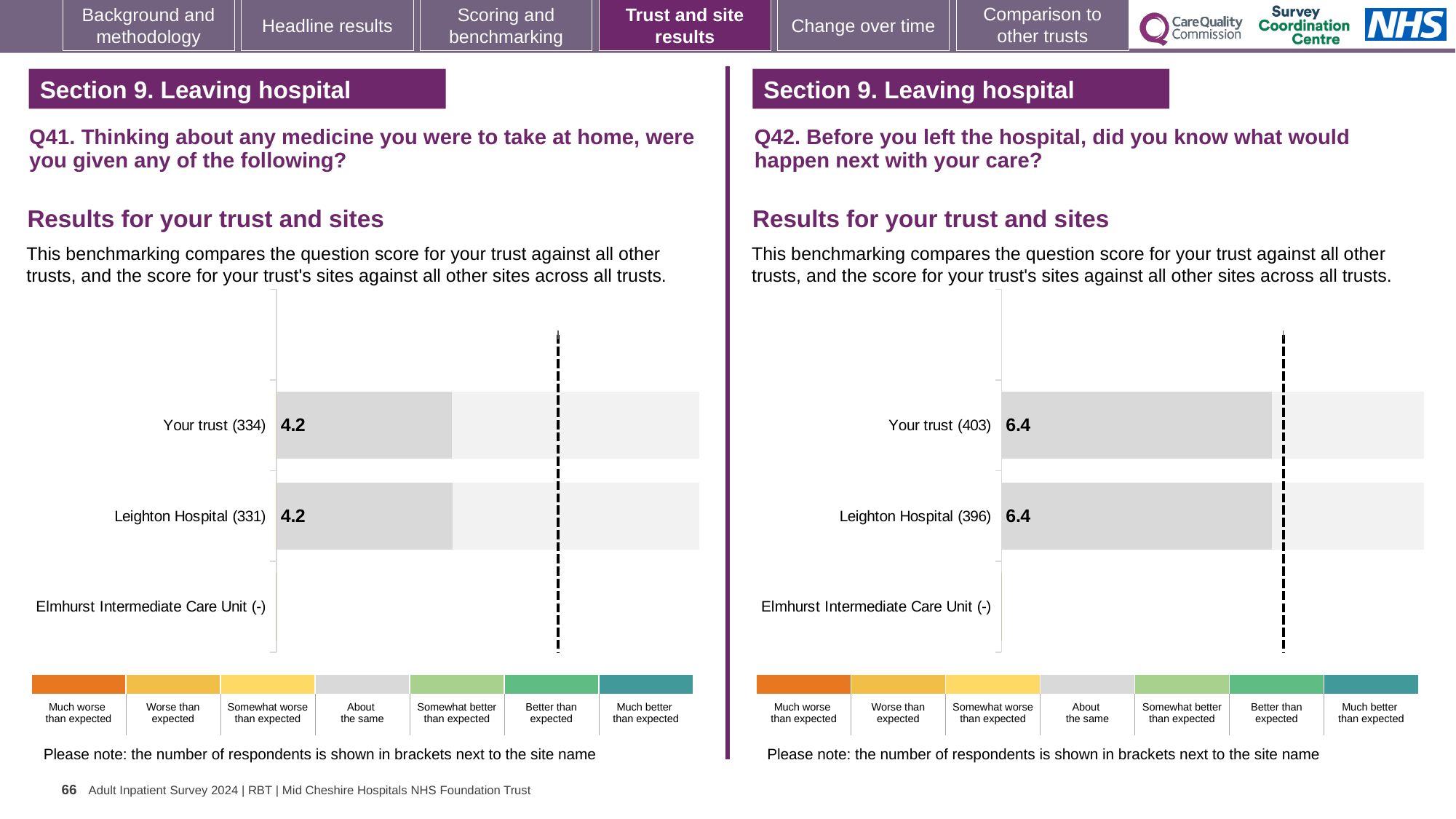
On the Q41 chart (left), what is the score for Leighton Hospital? 4.2 How many site/trust categories are listed on the Q41 chart (left)? 3 On the Q41 chart (left), what is the difference between the scores for Your trust and Leighton Hospital? 0.0 How many site/trust categories are listed on the Q42 chart (right)? 3 On the Q42 chart (right), what is the score for Leighton Hospital? 6.4 On the Q41 chart (left), what is the score for Your trust? 4.2 On the Q42 chart (right), what is the difference between the scores for Your trust and Leighton Hospital? 0.0 On the Q42 chart (right), how many respondents are shown in brackets for Leighton Hospital? 396 On the Q41 chart (left), which category has no score shown? Elmhurst Intermediate Care Unit What kind of chart is used on the Q42 chart (right)? Bar chart On the Q41 chart (left), how many respondents are shown in brackets for Your trust? 334 On the Q42 chart (right), what is the score for Your trust? 6.4